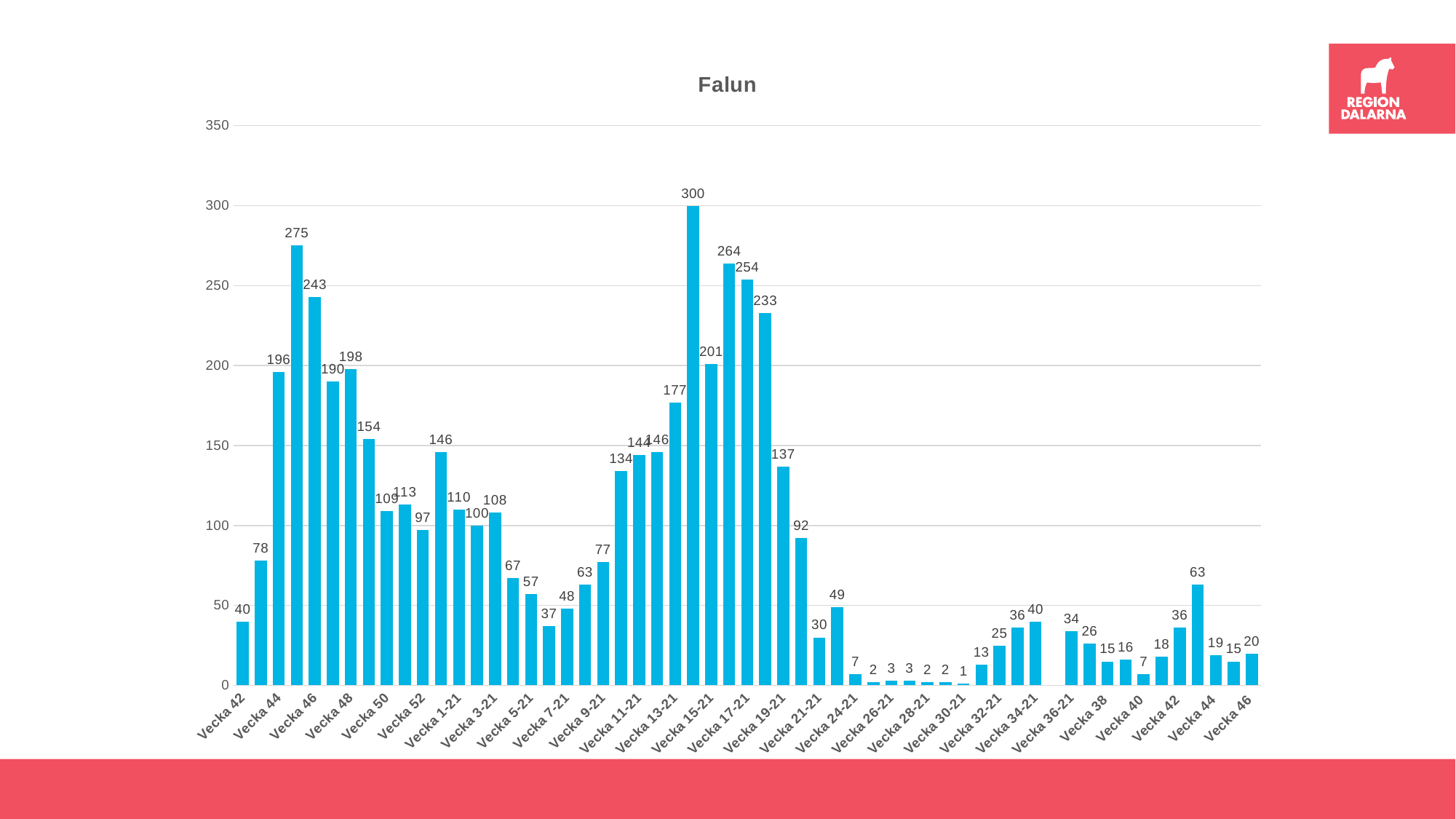
Do the values generally rise or fall from Vecka 17-21 to Vecka 24-21? fall What is the difference between the values for Vecka 15-21 and Vecka 13-21? 24 What is the value for Vecka 30-21? 1 Which week has the lowest value in the chart? Vecka 30-21 What is the highest value shown in the chart? 300 What is the title of the chart? Falun What type of chart is shown on the slide? bar chart Is the value for Vecka 19-21 greater or less than 100? greater What is the value for Vecka 48? 198 What is the value for Vecka 38? 15 Which is larger, the value for Vecka 50 or the value for Vecka 52? Vecka 50 What is the value for Vecka 17-21? 254